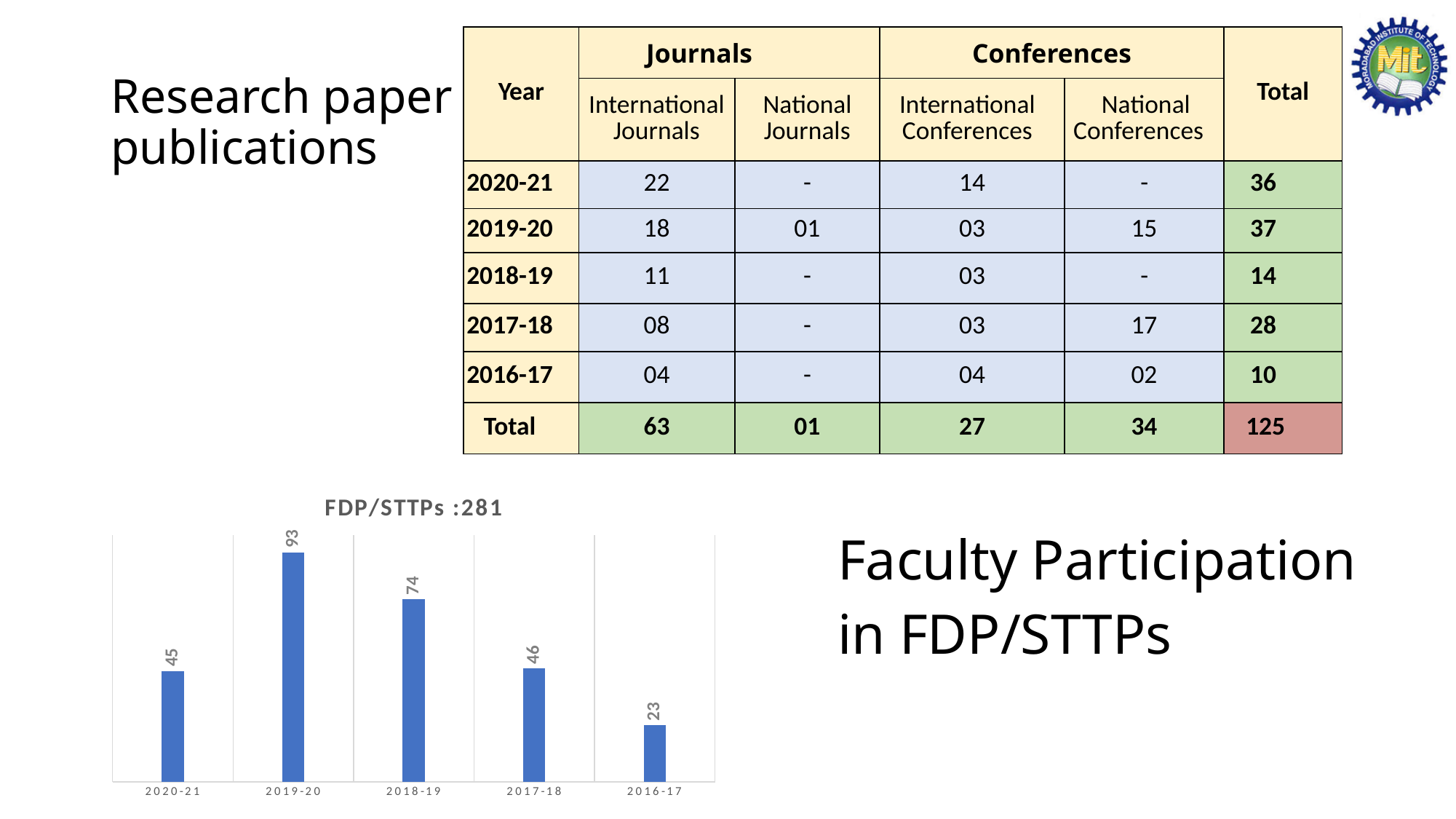
What colour are the bars in the FDP/STTPs chart? blue How many years are shown in the FDP/STTPs chart? 5 What is the value for 2019-20 in the FDP/STTPs chart? 93 What is the difference between the values for 2019-20 and 2018-19 in the FDP/STTPs chart? 19 What is the title of the bar chart on the slide? FDP/STTPs :281 Which year has the highest value in the FDP/STTPs chart? 2019-20 What is the difference between the values for 2017-18 and 2016-17 in the FDP/STTPs chart? 23 Which year has the lowest value in the FDP/STTPs chart? 2016-17 What is the value for 2018-19 in the FDP/STTPs chart? 74 What is the value for 2016-17 in the FDP/STTPs chart? 23 In the FDP/STTPs chart, which is larger: the value for 2018-19 or the value for 2020-21? 2018-19 What kind of chart is the FDP/STTPs chart? bar chart